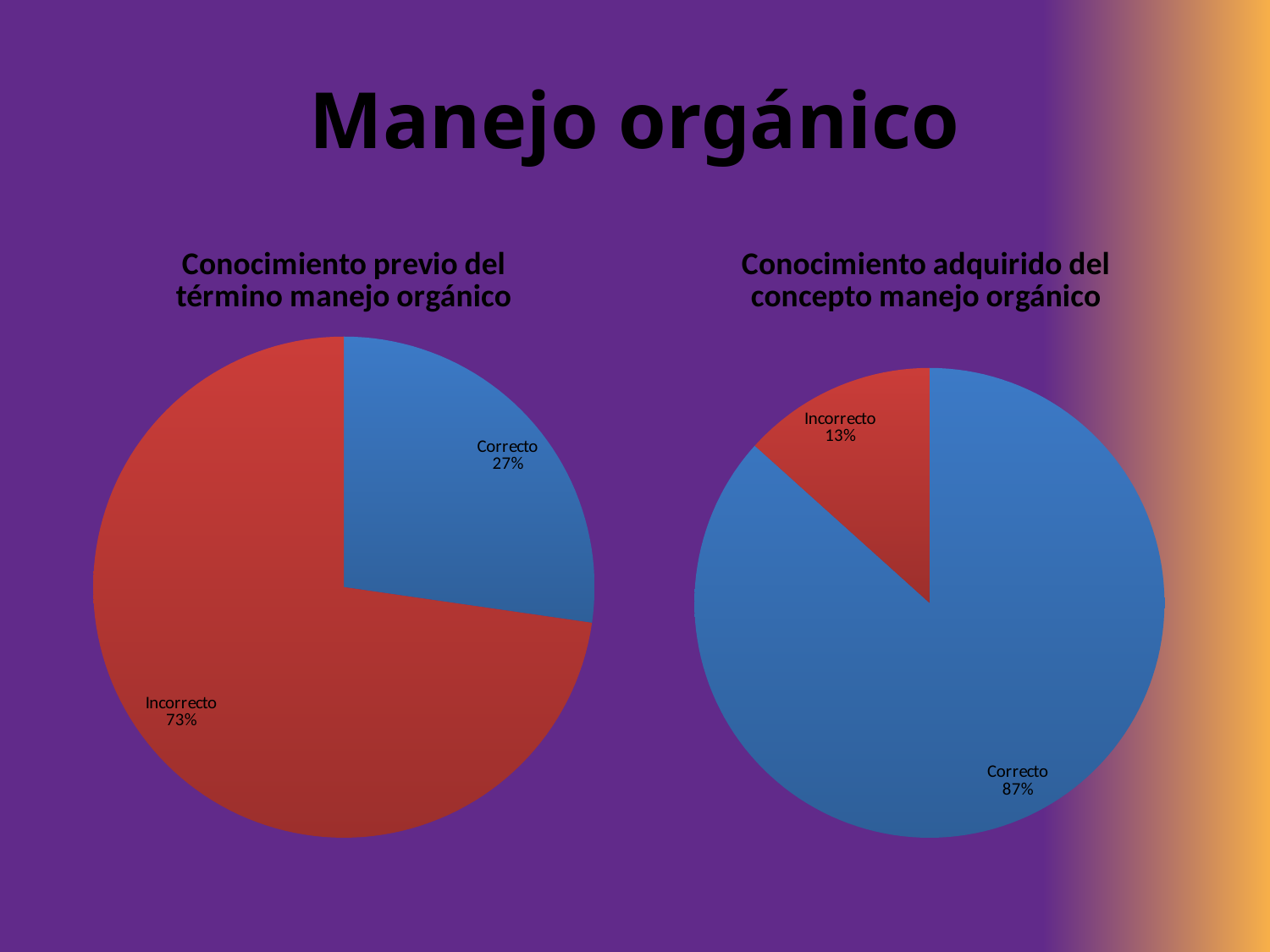
In the left chart, what is the difference between the Incorrecto and Correcto shares? 46% Which is larger: the Correcto share in the left chart or the Correcto share in the right chart? The right chart (87%) In the chart titled 'Conocimiento adquirido del concepto manejo orgánico', what share is labelled Incorrecto? 13% What colour is the Incorrecto slice in the left chart? Red In the right chart, what is the difference between the Correcto and Incorrecto shares? 74% In the right chart, which slice is the smallest? Incorrecto In the left chart, which slice is the largest? Incorrecto How many slices does the right chart have? 2 What kind of chart is used on the left side of the slide? Pie chart In the chart titled 'Conocimiento previo del término manejo orgánico', what share is labelled Correcto? 27% In the chart titled 'Conocimiento previo del término manejo orgánico', what share is labelled Incorrecto? 73% In the chart titled 'Conocimiento adquirido del concepto manejo orgánico', what share is labelled Correcto? 87%